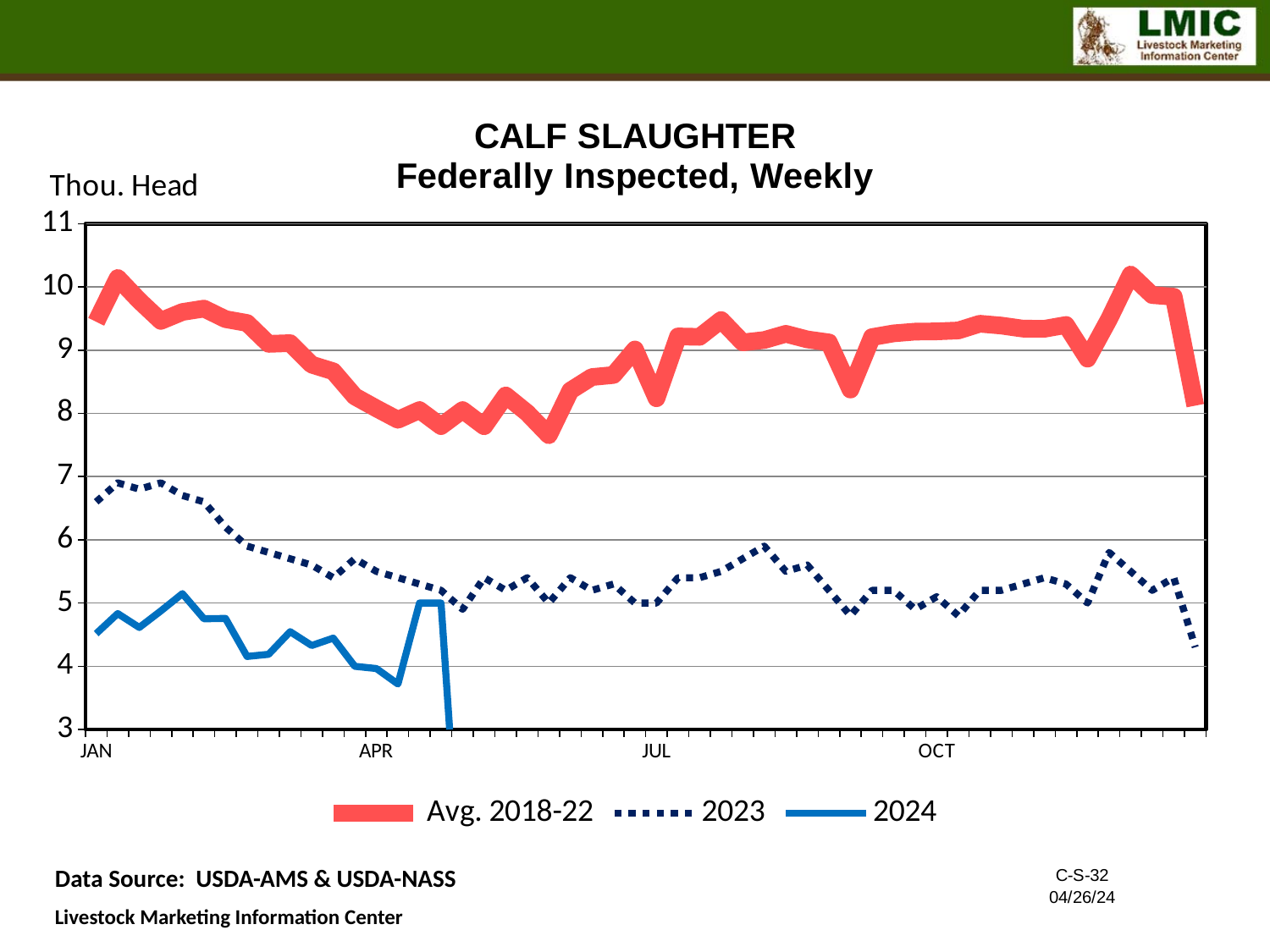
Is the value for 2023 at the end of the year greater or less than 5? less Which series has the lowest values in the JAN to APR period? 2024 Is the value for 2024 at JAN greater or less than 5? less Is the value for Avg. 2018-22 at JAN greater or less than 9? greater How many series does the legend list? 3 What is the title of the chart? CALF SLAUGHTER Federally Inspected, Weekly What kind of chart is shown on the slide? line chart Which series has the highest values throughout the year? Avg. 2018-22 Does the Avg. 2018-22 series rise or fall from JAN to APR? fall What unit label is shown on the y axis? Thou. Head At JAN, which is larger: the 2023 value or the 2024 value? 2023